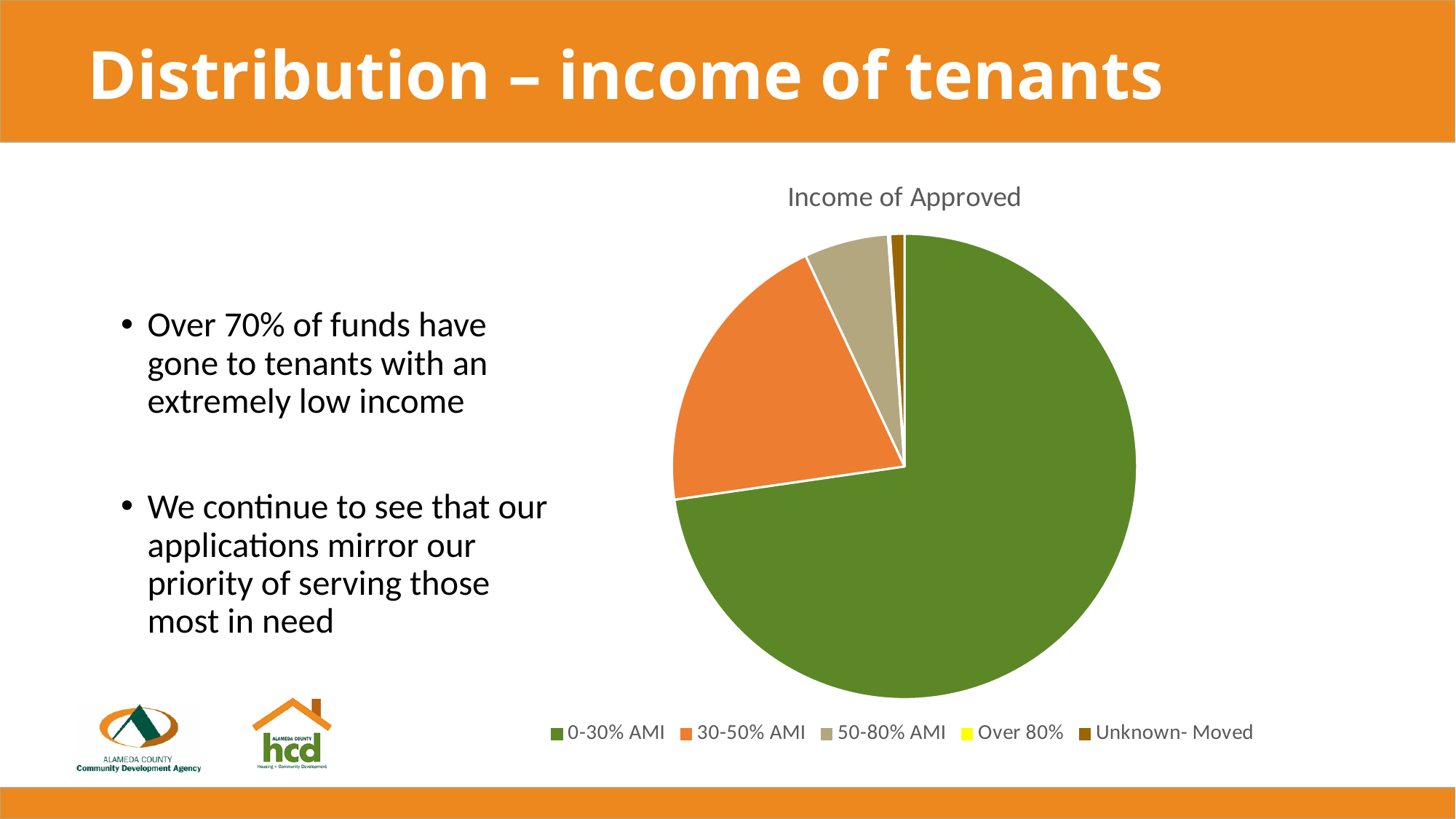
What is the title of the chart? Income of Approved Is the 0-30% AMI slice larger or smaller than half of the pie? larger Which slice is larger, 0-30% AMI or 30-50% AMI? 0-30% AMI What kind of chart is shown on the slide? pie chart Which slice is larger, 30-50% AMI or 50-80% AMI? 30-50% AMI Which colour represents the 30-50% AMI category in the chart? orange Which category has the largest slice of the pie? 0-30% AMI Which category is shown in green in the chart? 0-30% AMI How many categories does the chart's legend list? 5 Which slice is larger, 50-80% AMI or Unknown- Moved? 50-80% AMI